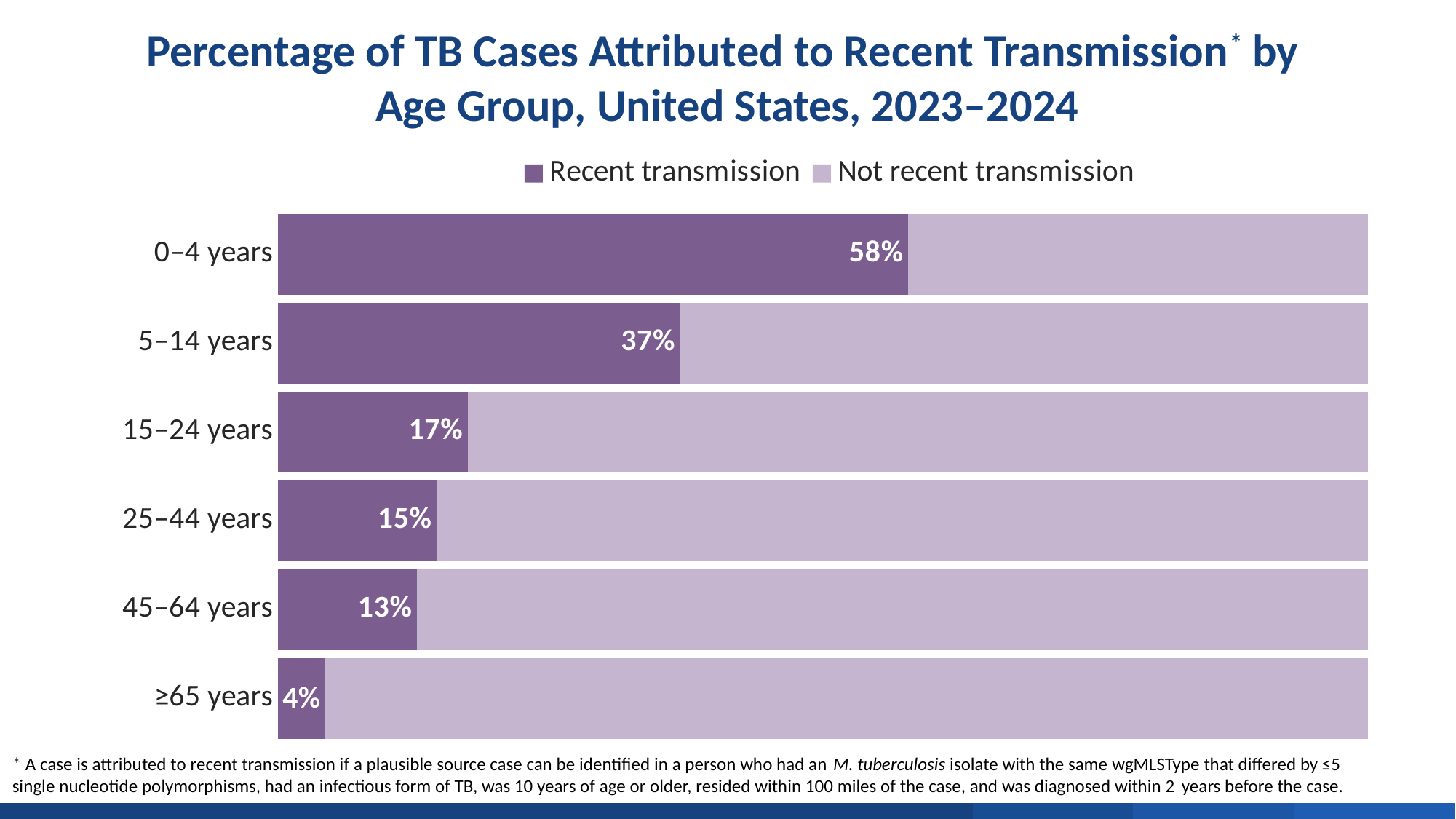
Which age group has the highest percentage of TB cases attributed to recent transmission? 0–4 years Does the recent transmission percentage rise or fall as age group increases from 0–4 years to ≥65 years? Fall Which age group has the lowest percentage of TB cases attributed to recent transmission? ≥65 years What percentage of TB cases among 0–4 years is attributed to recent transmission? 58% What kind of chart is shown on the slide? Stacked bar chart What percentage of TB cases among 45–64 years is attributed to recent transmission? 13% Which age group has a higher recent transmission percentage, 15–24 years or 25–44 years? 15–24 years What percentage of TB cases among 5–14 years is attributed to recent transmission? 37% How many series does the legend list? 2 How many age groups are shown in the chart? 6 What is the difference in the recent transmission percentage between 0–4 years and 5–14 years? 21 percentage points What percentage of TB cases among ≥65 years is attributed to recent transmission? 4%